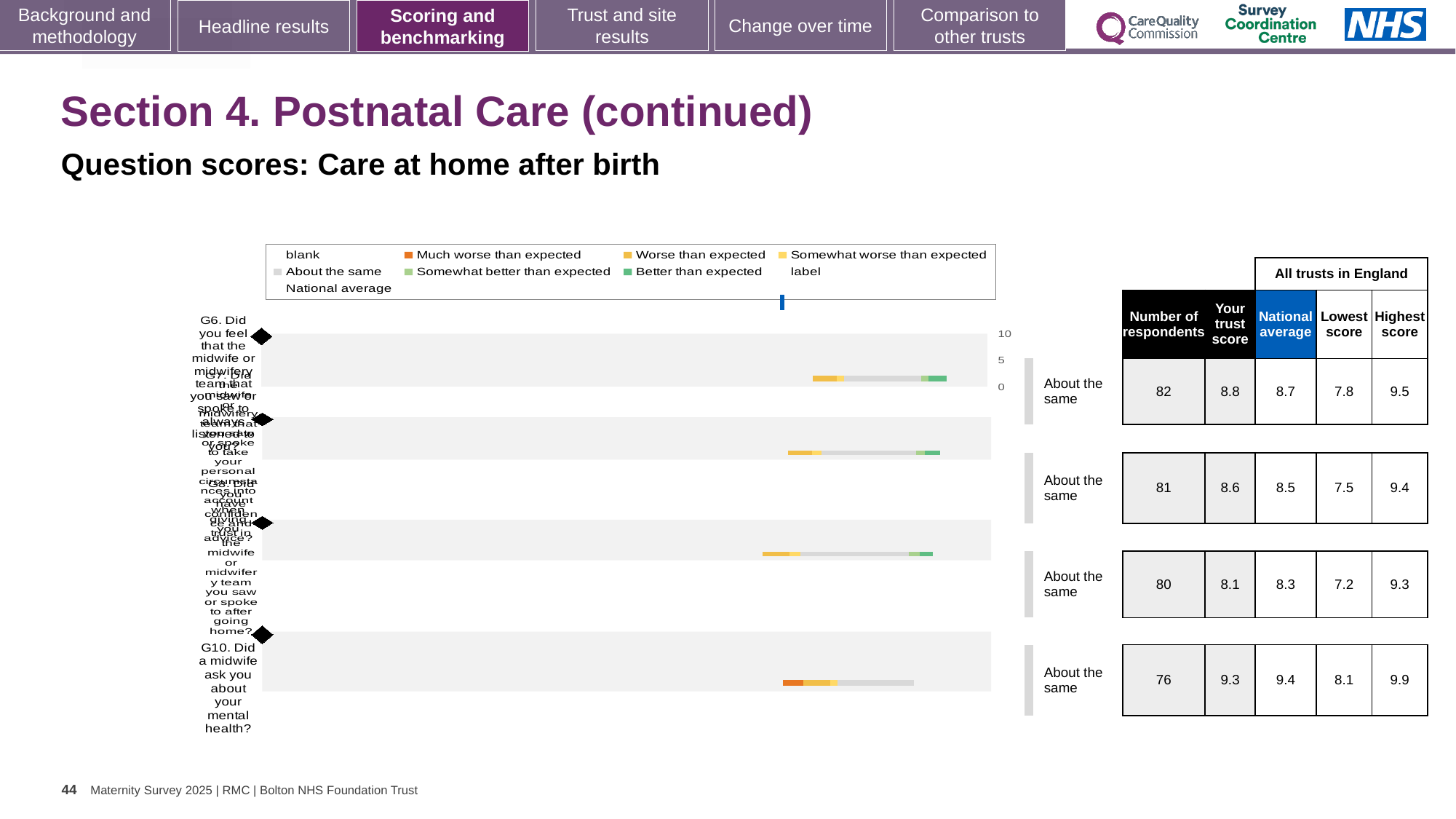
Which question row has the highest trust score? G10. Did a midwife ask you about your mental health? What is the trust score for the first question row, G6? 8.8 How many question rows (bars) are plotted in the chart? 4 Which question row has the fewest respondents? G10. Did a midwife ask you about your mental health? What is the highest score among all trusts in England for G10 (Did a midwife ask you about your mental health?)? 9.9 What benchmark category is shown for every question row in the chart? About the same How many respondents answered G10 (Did a midwife ask you about your mental health?)? 76 What is the trust score for G10 (Did a midwife ask you about your mental health?)? 9.3 What kind of chart is shown on the slide? Bar chart What is the difference between the highest score and the lowest score for G10 (Did a midwife ask you about your mental health?)? 1.8 What is the national average for G10 (Did a midwife ask you about your mental health?)? 9.4 What is the lowest score among all trusts in England for the first question row, G6? 7.8